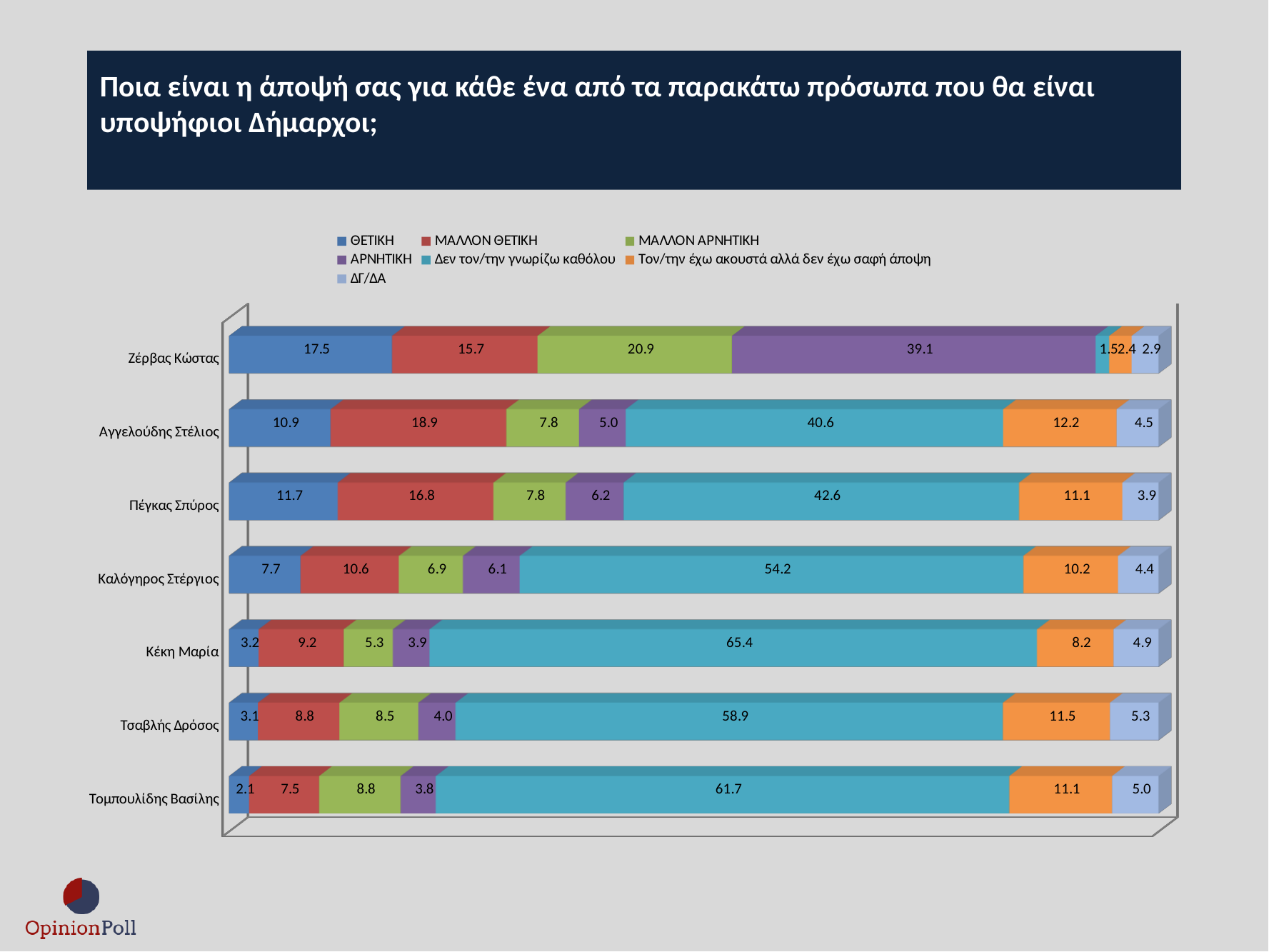
Which candidate has the highest ΘΕΤΙΚΗ value? Ζέρβας Κώστας What is the difference between the ΑΡΝΗΤΙΚΗ value for Ζέρβας Κώστας and the ΑΡΝΗΤΙΚΗ value for Αγγελούδης Στέλιος? 34.1 What kind of chart is shown on the slide? Stacked bar chart How many series does the legend list? 7 How many candidates are shown in the chart? 7 What is the total of the stacked bar for Ζέρβας Κώστας? 100.0 What is the 'Δεν τον/την γνωρίζω καθόλου' value for Κέκη Μαρία? 65.4 What is the ΑΡΝΗΤΙΚΗ value for Πέγκας Σπύρος? 6.2 Which candidate has the lowest ΘΕΤΙΚΗ value? Τομπουλίδης Βασίλης Which candidate has the highest 'Δεν τον/την γνωρίζω καθόλου' value? Κέκη Μαρία What is the ΘΕΤΙΚΗ value for Ζέρβας Κώστας? 17.5 Which is larger: the ΜΑΛΛΟΝ ΘΕΤΙΚΗ value for Αγγελούδης Στέλιος or for Πέγκας Σπύρος? Αγγελούδης Στέλιος